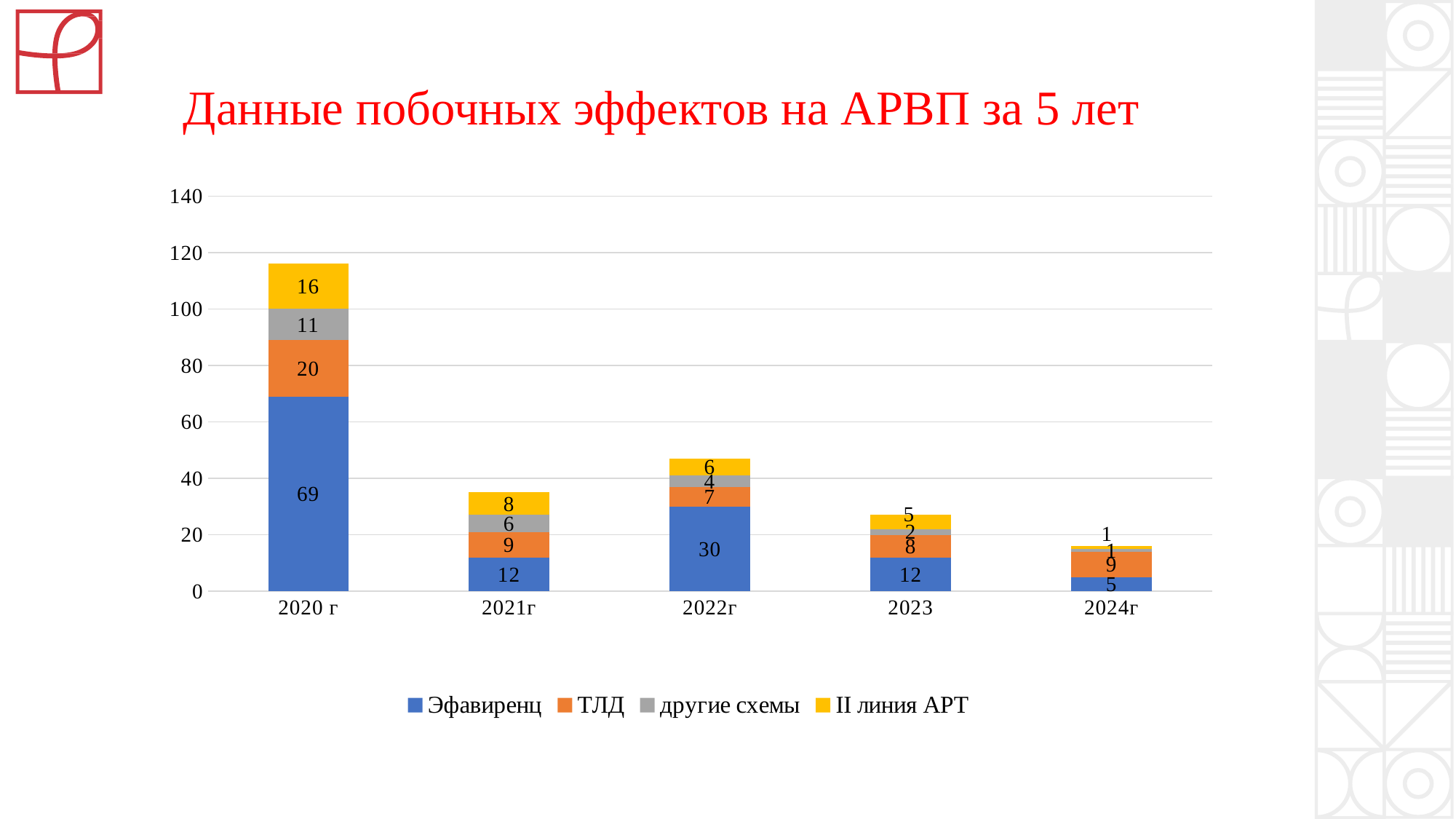
What is the value for II линия АРТ in 2021г? 8 How many series does the legend list? 4 What is the total of the stacked bar for 2020 г? 116 What is the value for Эфавиренц in 2020 г? 69 What is the total of the stacked bar for 2022г? 47 Which year has the lowest value for II линия АРТ? 2024г What kind of chart is shown on the slide? Stacked bar chart Which year has the highest value for Эфавиренц? 2020 г Which is larger: the ТЛД value in 2021г or the ТЛД value in 2023? 2021г What is the value for другие схемы in 2022г? 4 What is the value for ТЛД in 2024г? 9 What is the difference between the Эфавиренц values for 2020 г and 2022г? 39